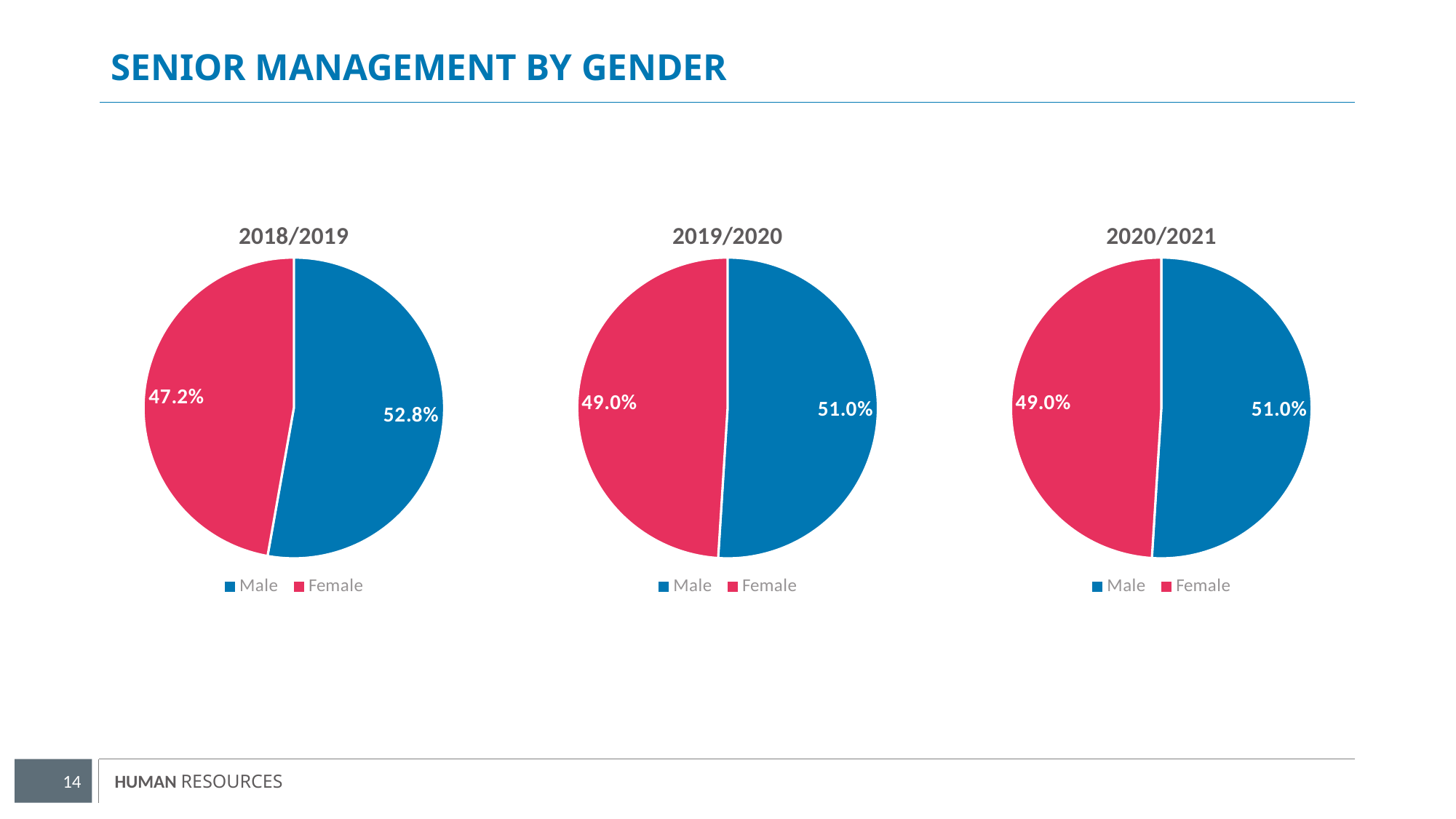
In the 2018/2019 chart, which slice is larger, Male or Female? Male How many entries does the legend of the 2018/2019 chart list? 2 In the 2018/2019 chart, what is the difference between the Male and Female percentages? 5.6% How many slices does the 2020/2021 chart have? 2 How many pie charts are shown on the slide? 3 In the 2018/2019 chart, what percentage of senior management is Male? 52.8% In the 2018/2019 chart, what percentage of senior management is Female? 47.2% What kind of chart is used for 2019/2020? Pie chart In the 2020/2021 chart, what percentage of senior management is Male? 51.0% In the 2019/2020 chart, what percentage of senior management is Female? 49.0% In the 2019/2020 chart, what colour represents Female? Red In the 2020/2021 chart, what is the difference between the Male and Female percentages? 2.0%